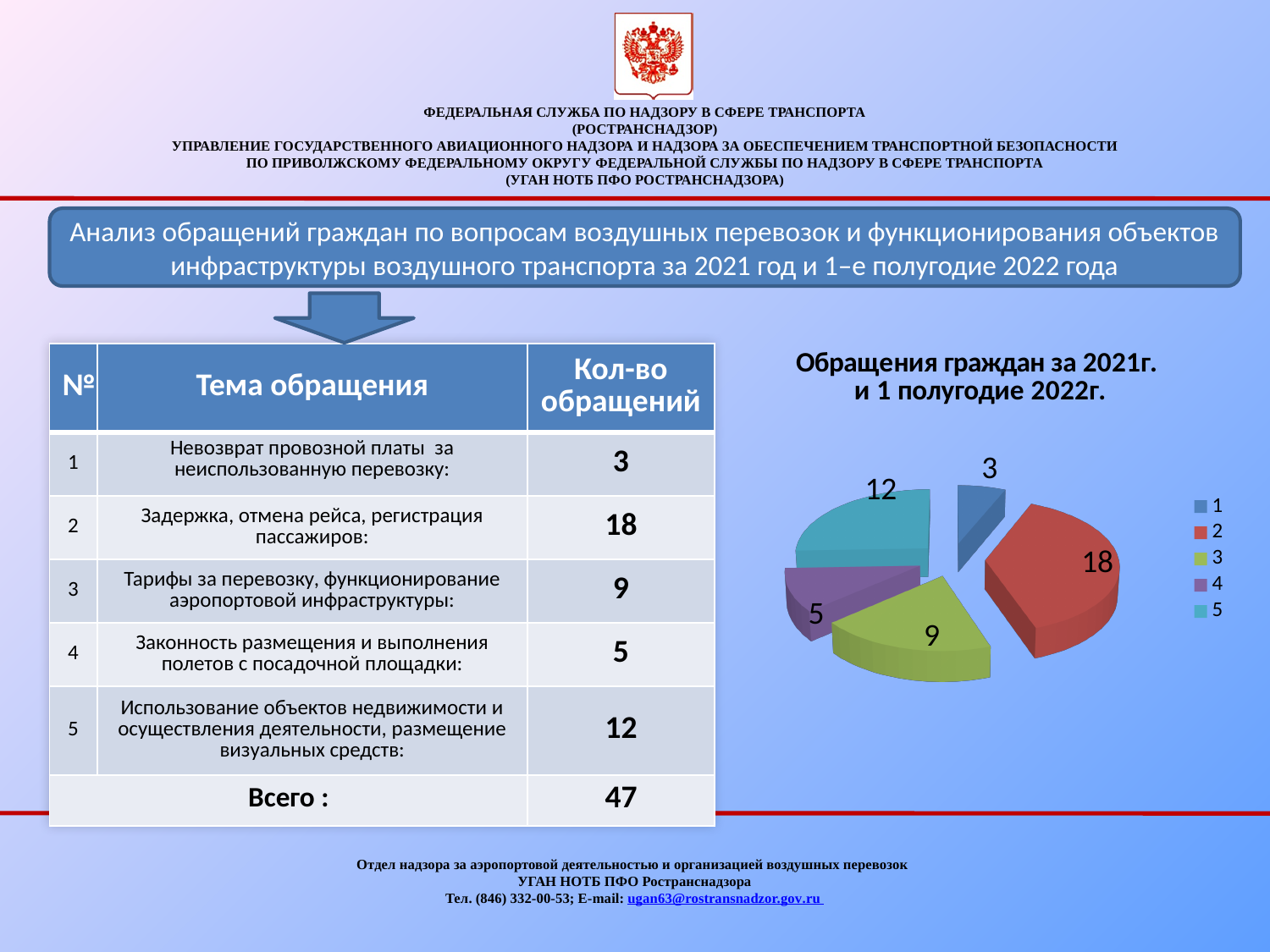
What is the value of slice 5 in the pie chart? 12 What is the value of slice 2 in the pie chart? 18 How many slices does the pie chart have? 5 Which is larger in the pie chart, slice 3 or slice 5? 5 What type of chart is shown on the slide? pie chart What is the total of all slice values in the pie chart? 47 How many entries does the legend of the pie chart list? 5 What is the value of slice 4 in the pie chart? 5 Which slice of the pie chart has the largest value? 2 What is the title of the pie chart? Обращения граждан за 2021г. и 1 полугодие 2022г. What is the difference between the values of slice 2 and slice 3 in the pie chart? 9 Which slice of the pie chart has the smallest value? 1